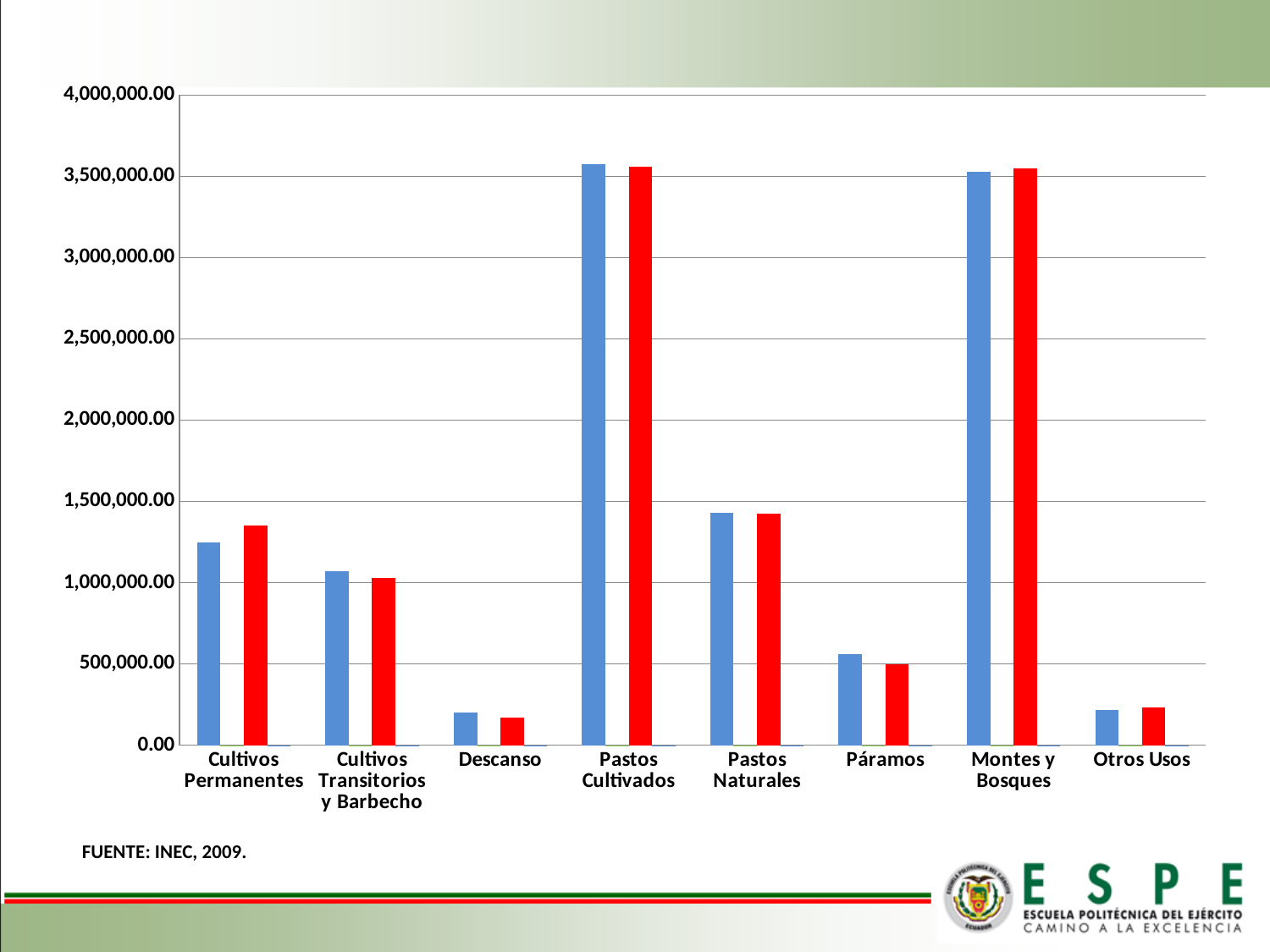
For Páramos, which bar is taller, the blue one or the red one? the blue one What kind of chart is shown on the slide? bar chart Is the red bar for Cultivos Permanentes greater or less than 1,000,000.00? greater What source is cited below the chart? FUENTE: INEC, 2009. Is the blue bar for Descanso greater or less than 500,000.00? less Is the red bar for Pastos Naturales greater or less than 1,500,000.00? less How many categories are shown on the x axis of the chart? 8 Which category has the lowest red bar? Descanso For Cultivos Permanentes, which bar is taller, the blue one or the red one? the red one How many bars are plotted for each category in the chart? 2